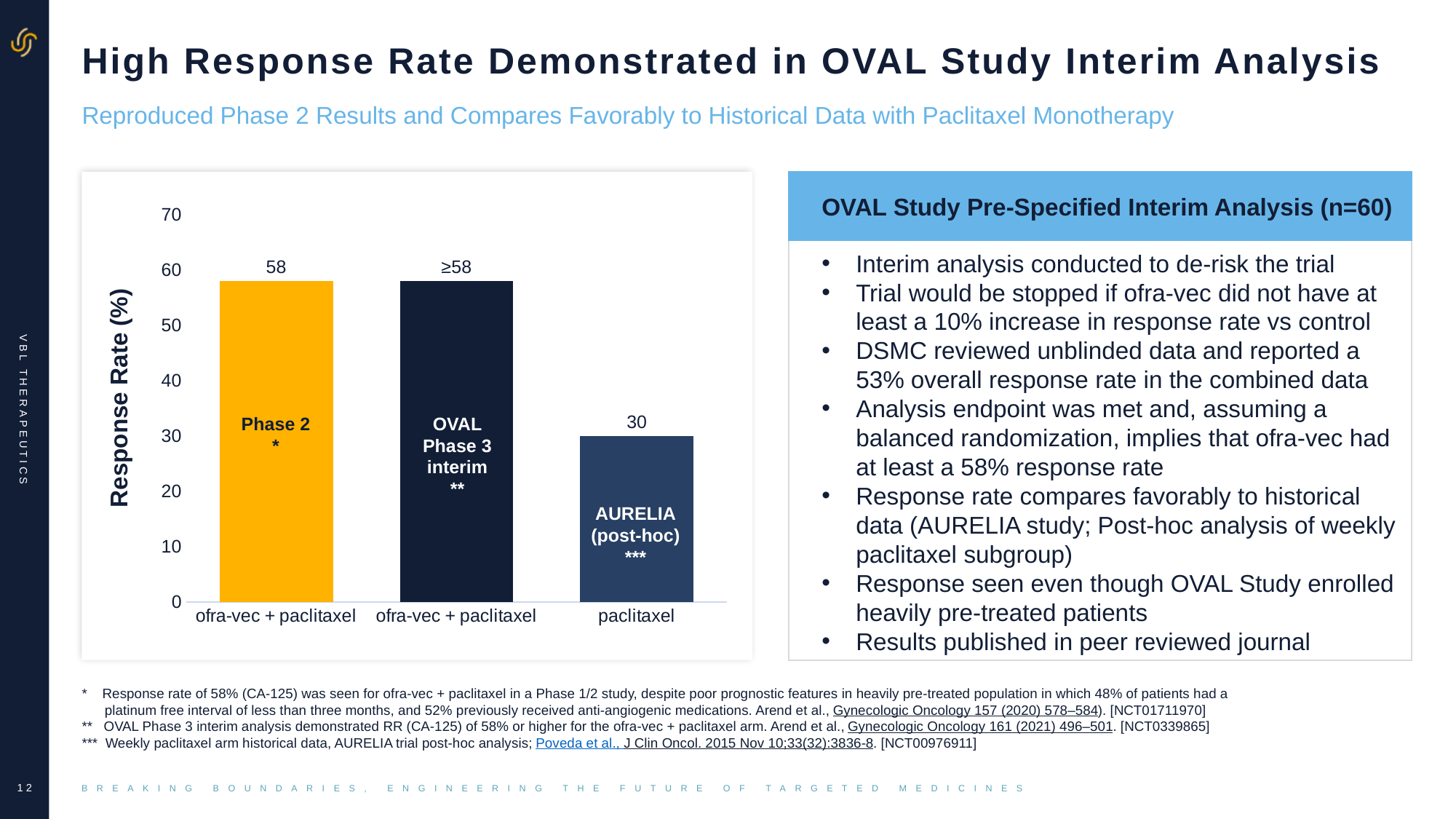
Is the value for the paclitaxel bar greater or less than 40? less What is the difference between the Phase 2 ofra-vec + paclitaxel response rate and the paclitaxel response rate? 28 What kind of chart is shown on the slide? bar chart What is the response rate shown for the Phase 2 ofra-vec + paclitaxel bar? 58 What value is labelled on the OVAL Phase 3 interim ofra-vec + paclitaxel bar? ≥58 How many bars are plotted in the chart? 3 What is the response rate shown for the paclitaxel (AURELIA post-hoc) bar? 30 Which is larger, the Phase 2 ofra-vec + paclitaxel response rate or the paclitaxel response rate? Phase 2 ofra-vec + paclitaxel Which bar has the lowest response rate? paclitaxel (AURELIA post-hoc) Is the value for the Phase 2 ofra-vec + paclitaxel bar greater or less than 50? greater What colour is the Phase 2 ofra-vec + paclitaxel bar? orange What is the title of the vertical axis of the chart? Response Rate (%)